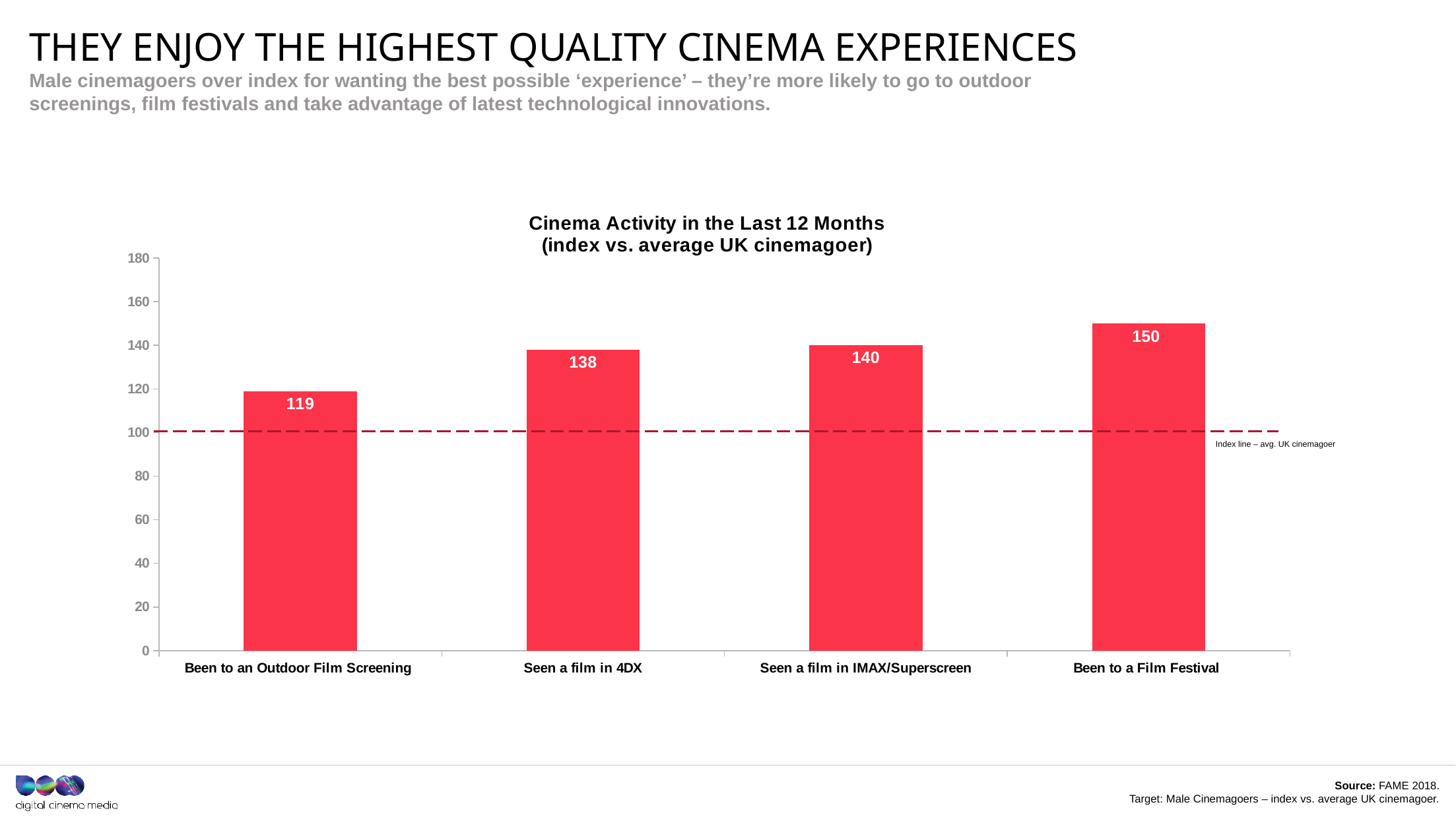
What is the index value for 'Seen a film in 4DX'? 138 Is the value for 'Been to an Outdoor Film Screening' greater or less than 100? greater What is the difference between the index for 'Been to a Film Festival' and 'Been to an Outdoor Film Screening'? 31 Which activity has the highest index value? Been to a Film Festival What is the index value for 'Been to a Film Festival'? 150 Which has a higher index: 'Seen a film in 4DX' or 'Been to a Film Festival'? Been to a Film Festival What is the index value for 'Been to an Outdoor Film Screening'? 119 How many activity categories are shown in the chart? 4 What type of chart is shown on the slide? Bar chart Which activity has the lowest index value? Been to an Outdoor Film Screening What is the index value for 'Seen a film in IMAX/Superscreen'? 140 What value does the dashed index line mark on the chart? 100